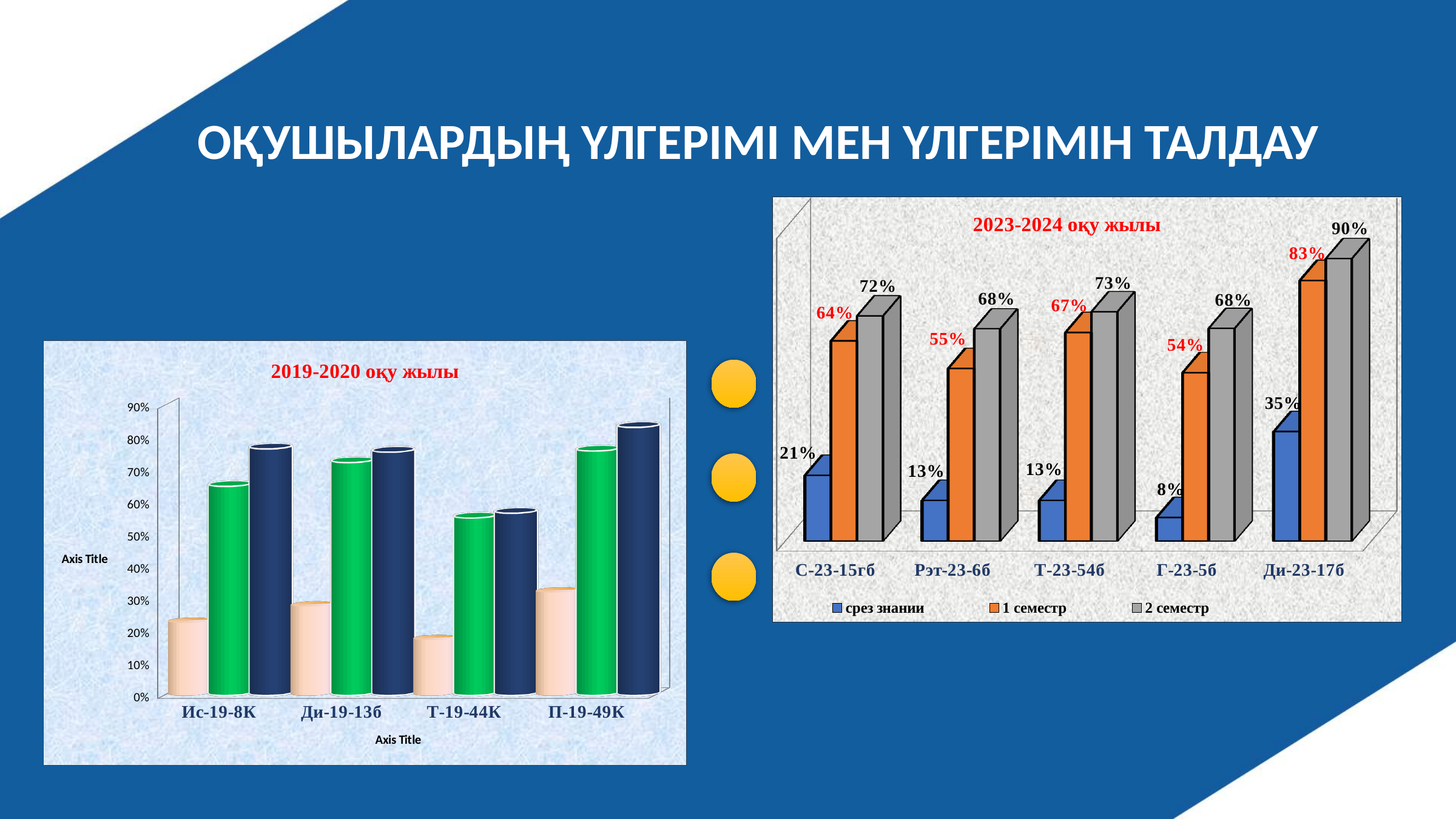
What kind of chart is the 2019-2020 оқу жылы chart? Bar chart In the 2023-2024 оқу жылы chart, what is the 2 семестр value for Ди-23-17б? 90% In the 2023-2024 оқу жылы chart, what is the 1 семестр value for Рэт-23-6б? 55% How many categories are shown on the x axis of the 2019-2020 оқу жылы chart? 4 In the 2023-2024 оқу жылы chart, which category has the lowest срез знании value? Г-23-5б How many series does the legend of the 2023-2024 оқу жылы chart list? 3 In the 2019-2020 оқу жылы chart, is the green bar for Т-19-44К greater or less than 60%? less In the 2023-2024 оқу жылы chart, what is the срез знании value for Г-23-5б? 8% In the 2019-2020 оқу жылы chart, is the dark blue bar for П-19-49К greater or less than 70%? greater In the 2023-2024 оқу жылы chart, what is the difference between the 2 семестр and 1 семестр values for С-23-15гб? 8% In the 2023-2024 оқу жылы chart, which category has the highest 1 семестр value? Ди-23-17б In the 2023-2024 оқу жылы chart, which is larger: the 1 семестр value for Т-23-54б or for Г-23-5б? Т-23-54б